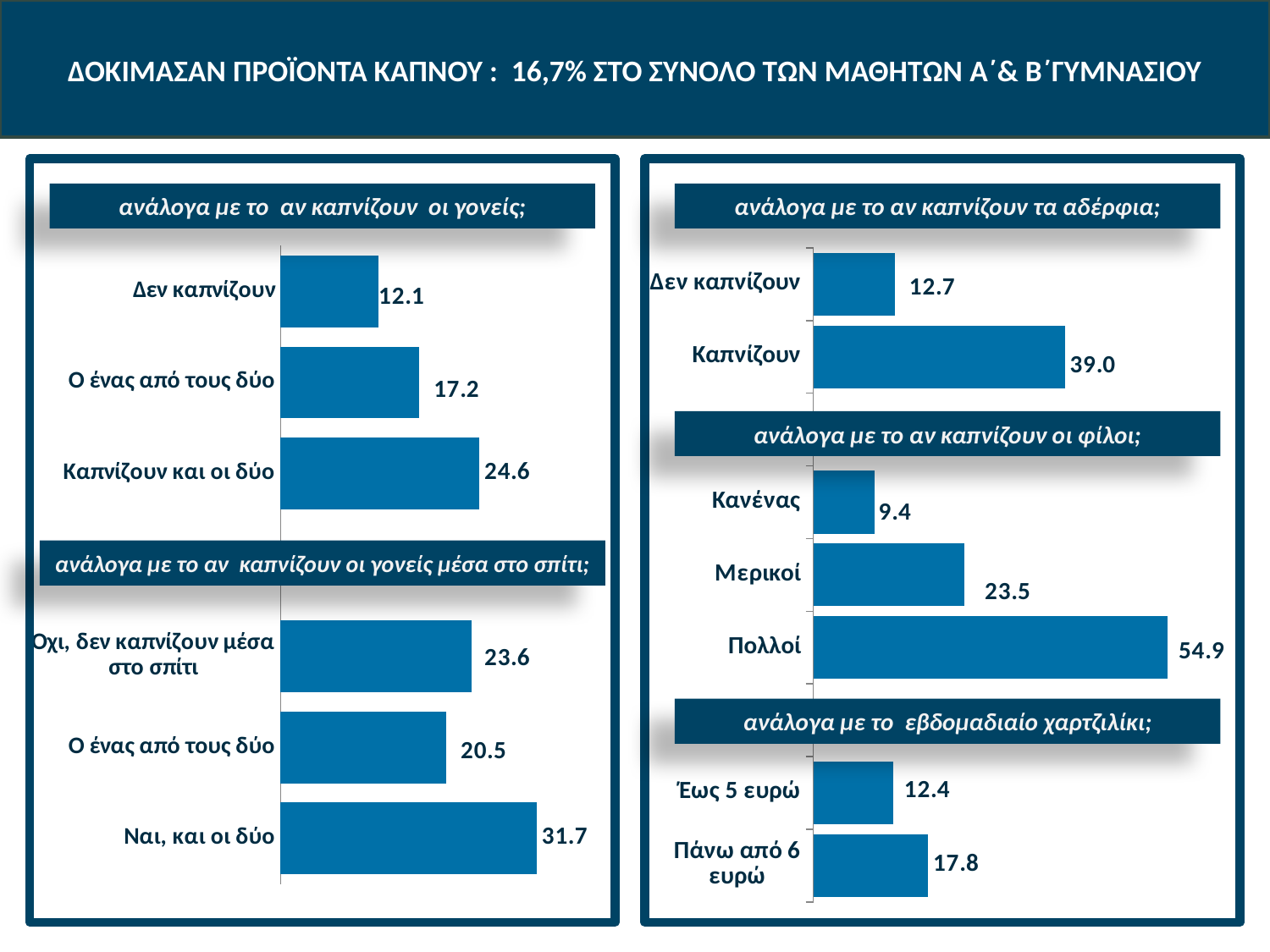
In the chart titled 'ανάλογα με το αν καπνίζουν οι γονείς μέσα στο σπίτι;', what is the value for 'Ναι, και οι δύο'? 31.7 In the chart titled 'ανάλογα με το αν καπνίζουν οι φίλοι;', what is the difference between 'Πολλοί' and 'Μερικοί'? 31.4 In the chart titled 'ανάλογα με το αν καπνίζουν οι φίλοι;', which category has the highest value? Πολλοί In the chart titled 'ανάλογα με το αν καπνίζουν τα αδέρφια;', how many categories are shown? 2 In the chart titled 'ανάλογα με το αν καπνίζουν οι γονείς μέσα στο σπίτι;', what is the difference between 'Ναι, και οι δύο' and 'Ο ένας από τους δύο'? 11.2 In the chart titled 'ανάλογα με το αν καπνίζουν οι γονείς;', which category has the lowest value? Δεν καπνίζουν What type of chart is used in the chart titled 'ανάλογα με το αν καπνίζουν οι φίλοι;'? Bar chart In the chart titled 'ανάλογα με το εβδομαδιαίο χαρτζιλίκι;', which is larger: 'Έως 5 ευρώ' or 'Πάνω από 6 ευρώ'? Πάνω από 6 ευρώ In the chart titled 'ανάλογα με το αν καπνίζουν τα αδέρφια;', what is the value for 'Καπνίζουν'? 39.0 In the chart titled 'ανάλογα με το αν καπνίζουν οι φίλοι;', what is the value for 'Κανένας'? 9.4 In the chart titled 'ανάλογα με το εβδομαδιαίο χαρτζιλίκι;', what is the value for 'Έως 5 ευρώ'? 12.4 In the chart titled 'ανάλογα με το αν καπνίζουν οι γονείς;', what is the value for 'Καπνίζουν και οι δύο'? 24.6